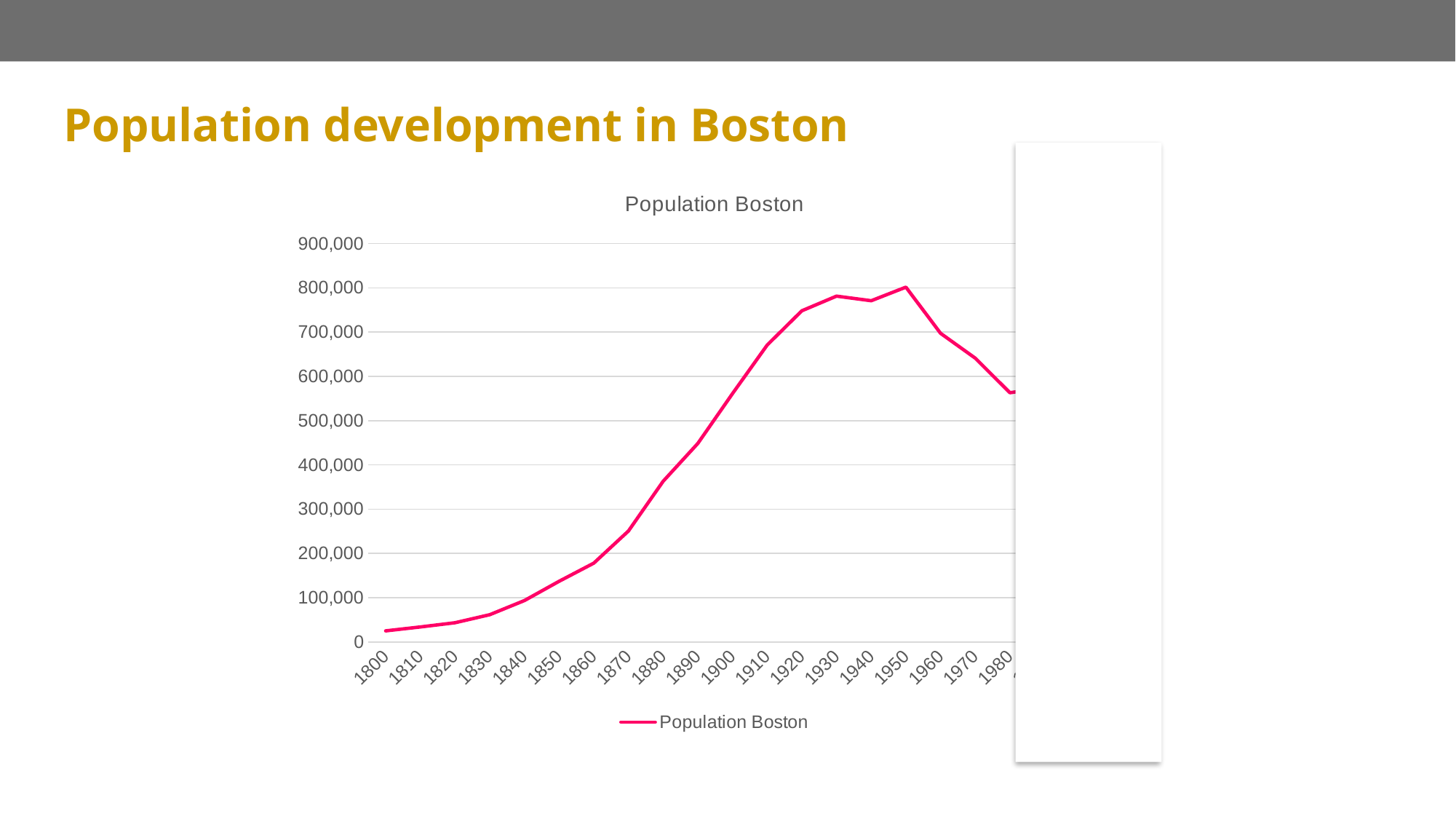
What colour is the line for Population Boston? pink In which year shown on the x axis does the population of Boston reach its highest value? 1950 How many series does the legend list? 1 What is the title of the chart? Population Boston Does the population of Boston rise or fall between 1800 and 1950? rise What kind of chart is shown on the slide? line chart In which year shown on the x axis is the population of Boston lowest? 1800 Is the value for 1900 greater or less than 500,000? greater Does the population of Boston rise or fall between 1950 and 1980? fall Is the value for 1920 greater or less than 700,000? greater Which year has the larger population, 1960 or 1980? 1960